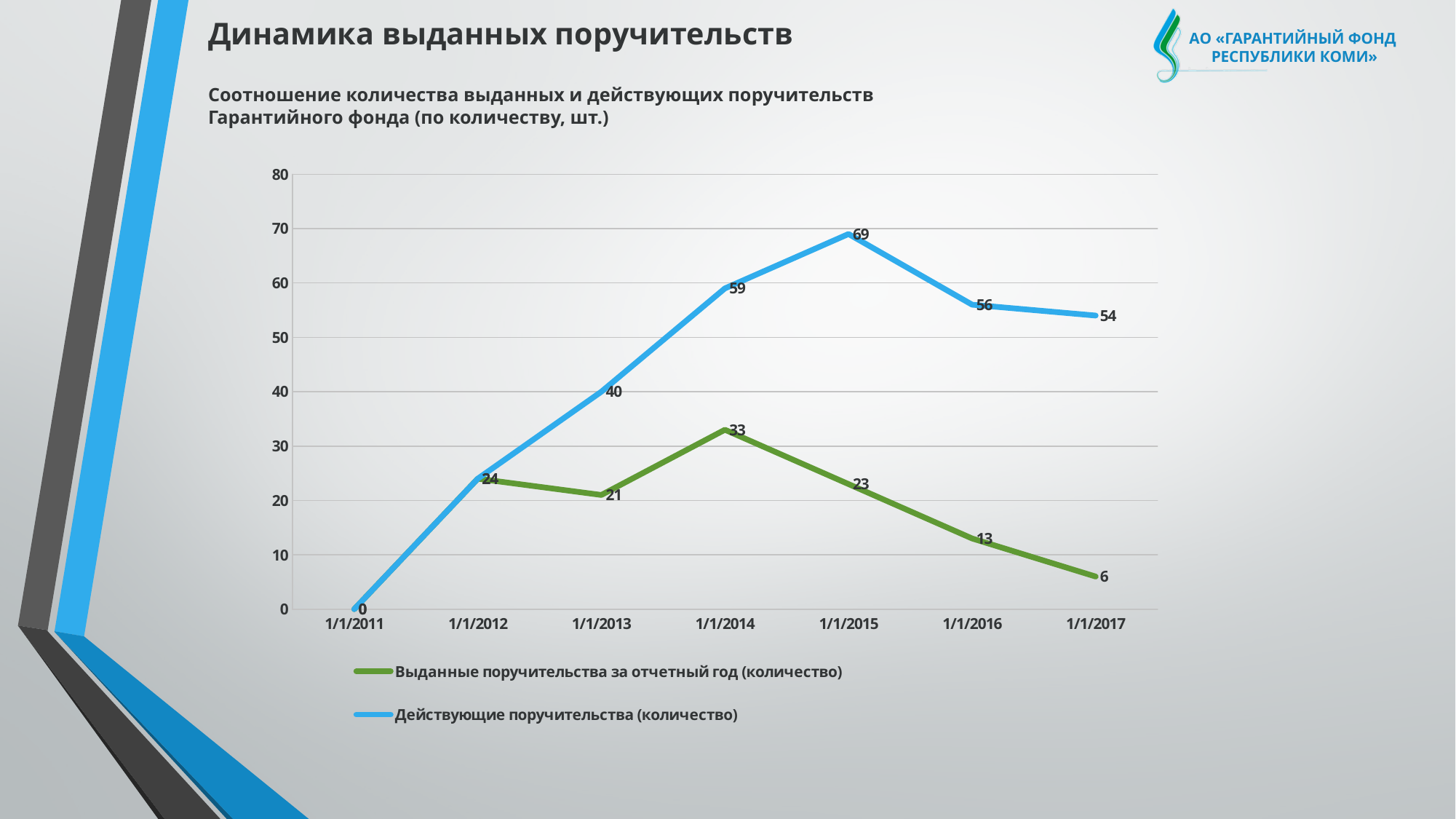
What is the value of Выданные поручительства за отчетный год (количество) at 1/1/2017? 6 At which date does Действующие поручительства (количество) reach its highest value? 1/1/2015 How many dates are shown on the x axis? 7 What is the difference between Действующие поручительства (количество) and Выданные поручительства за отчетный год (количество) at 1/1/2016? 43 What is the value of Выданные поручительства за отчетный год (количество) at 1/1/2014? 33 At which date is Выданные поручительства за отчетный год (количество) lowest? 1/1/2011 What is the value of Действующие поручительства (количество) at 1/1/2017? 54 Which series has the larger value at 1/1/2015? Действующие поручительства (количество) Does Выданные поручительства за отчетный год (количество) rise or fall from 1/1/2014 to 1/1/2017? fall How many series does the legend list? 2 What is the value of Действующие поручительства (количество) at 1/1/2015? 69 What kind of chart is shown on the slide? line chart